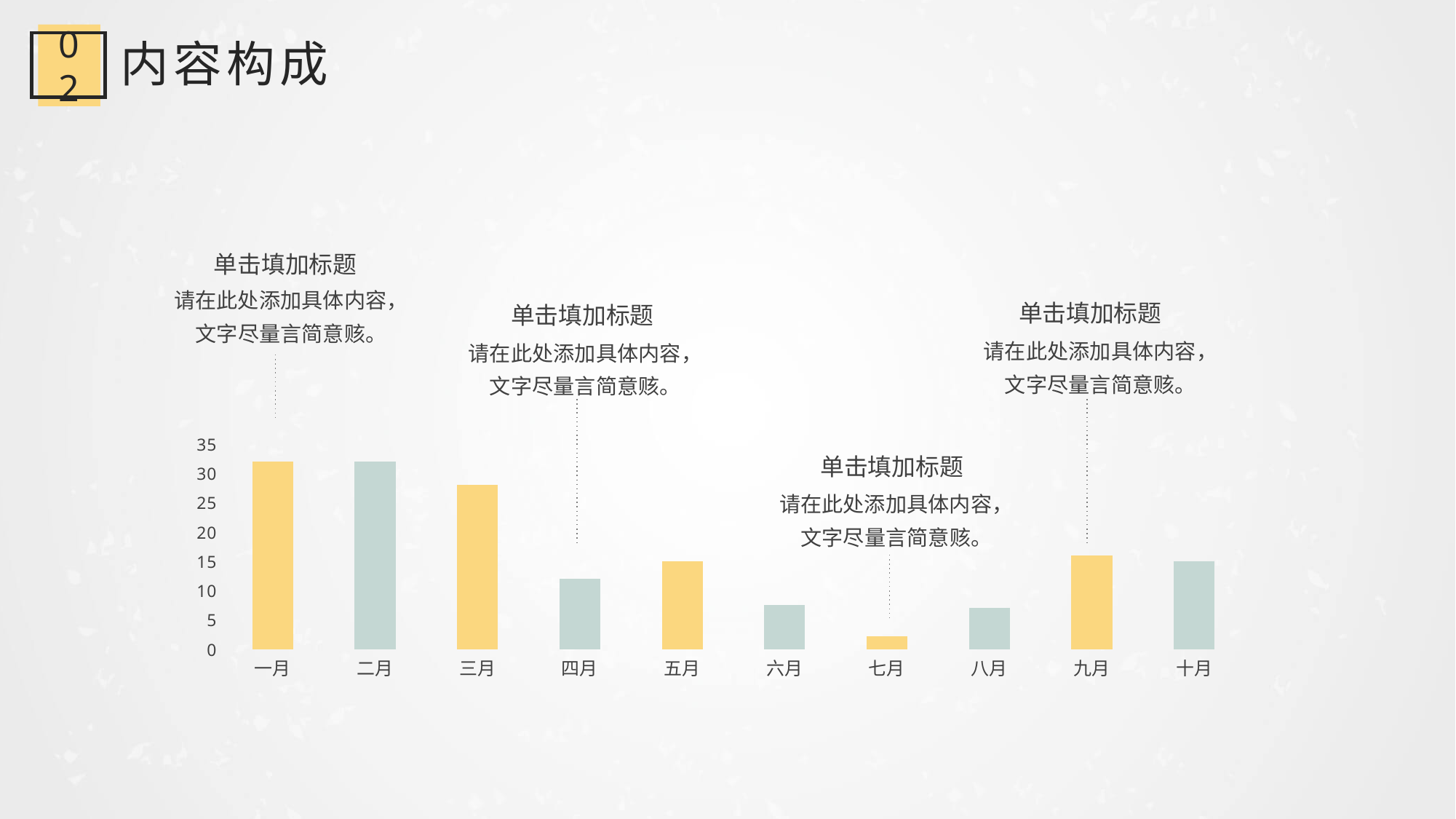
Is the value for 七月 greater or less than 5? less Is the value for 一月 greater or less than 30? greater Which is larger, the value for 九月 or the value for 八月? 九月 Which is larger, the value for 三月 or the value for 四月? 三月 How many months are shown on the x axis of the chart? 10 What kind of chart is shown on the slide? bar chart Is the value for 六月 greater or less than 10? less Which month has the lowest bar in the chart? 七月 What colour is the bar for 一月? yellow What is the highest tick value shown on the y axis of the chart? 35